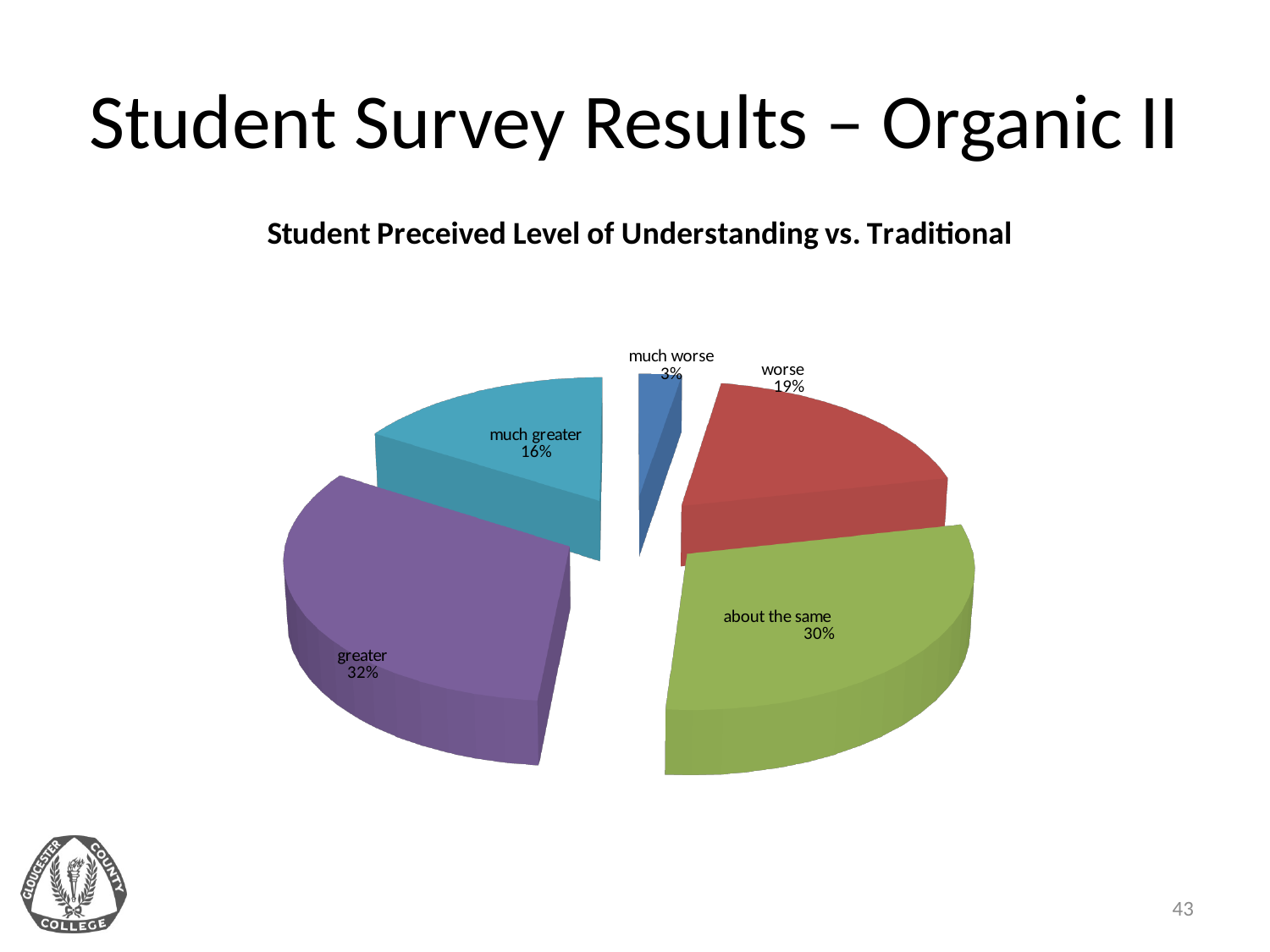
What is the difference in percentage points between "worse" and "much worse"? 16 What percentage of students answered "greater"? 32% What is the title of the chart? Student Preceived Level of Understanding vs. Traditional What percentage of students answered "much greater"? 16% What percentage of students answered "much worse"? 3% What percentage of students answered "about the same"? 30% How many slices does the pie chart have? 5 Which response has the largest share of the pie? greater Which is larger, the share for "much greater" or the share for "worse"? worse What kind of chart is shown on the slide? pie chart What percentage of students answered "worse"? 19% Which response has the smallest share of the pie? much worse